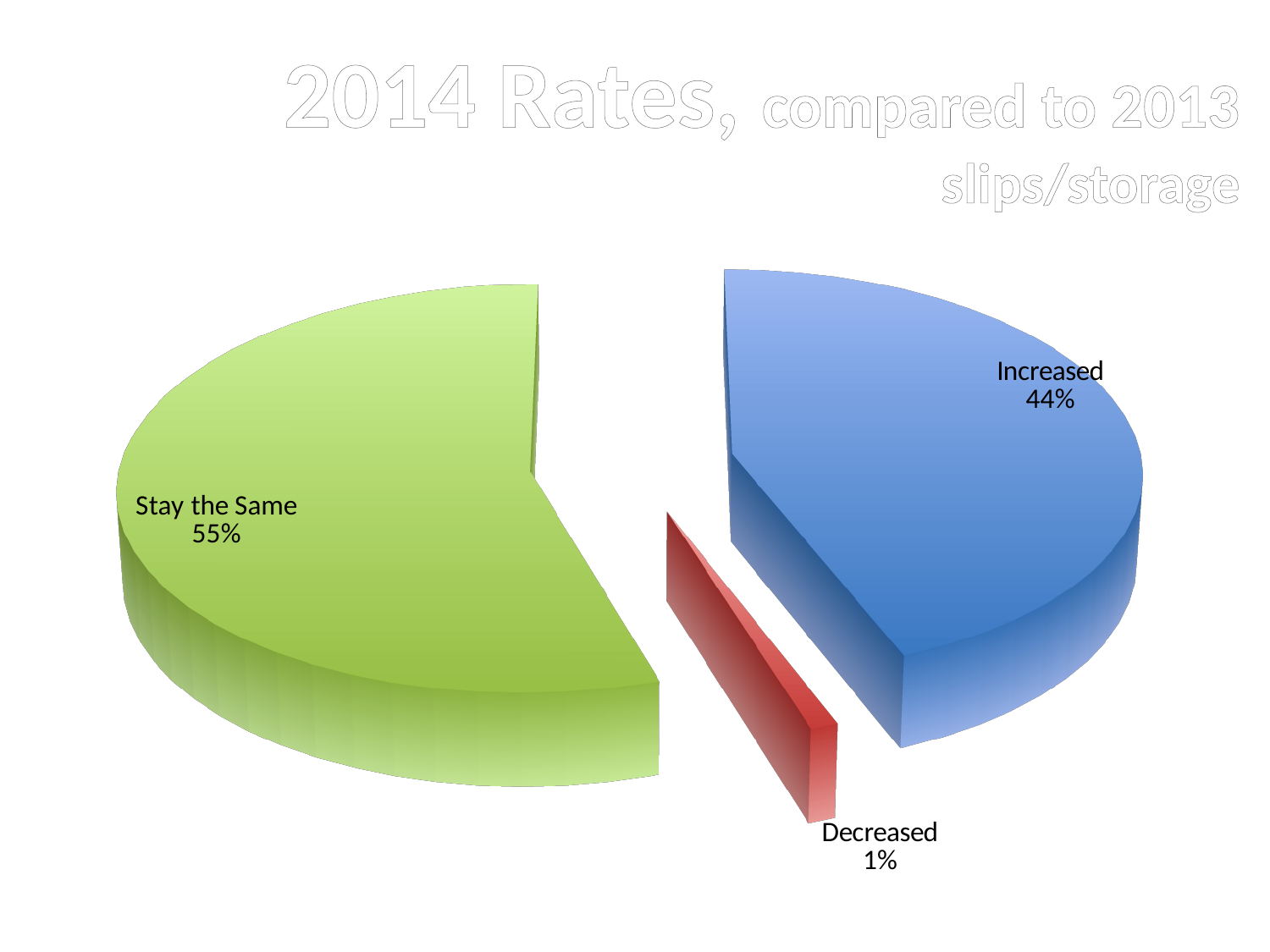
What percentage of respondents reported that slips/storage rates increased in 2014 compared to 2013? 44% What percentage of respondents reported that slips/storage rates decreased? 1% What is the title of the chart? 2014 Rates, compared to 2013 slips/storage Which category has the smallest share of the pie? Decreased What is the difference in percentage points between Increased and Decreased? 43 What percentage of respondents reported that slips/storage rates stayed the same? 55% How many categories are shown in the pie chart? 3 What kind of chart is shown on the slide? Pie chart What is the difference in percentage points between Stay the Same and Increased? 11 What colour is the slice for Increased? Blue Which category has the largest share of the pie? Stay the Same Which is larger, the share for Increased or the share for Decreased? Increased